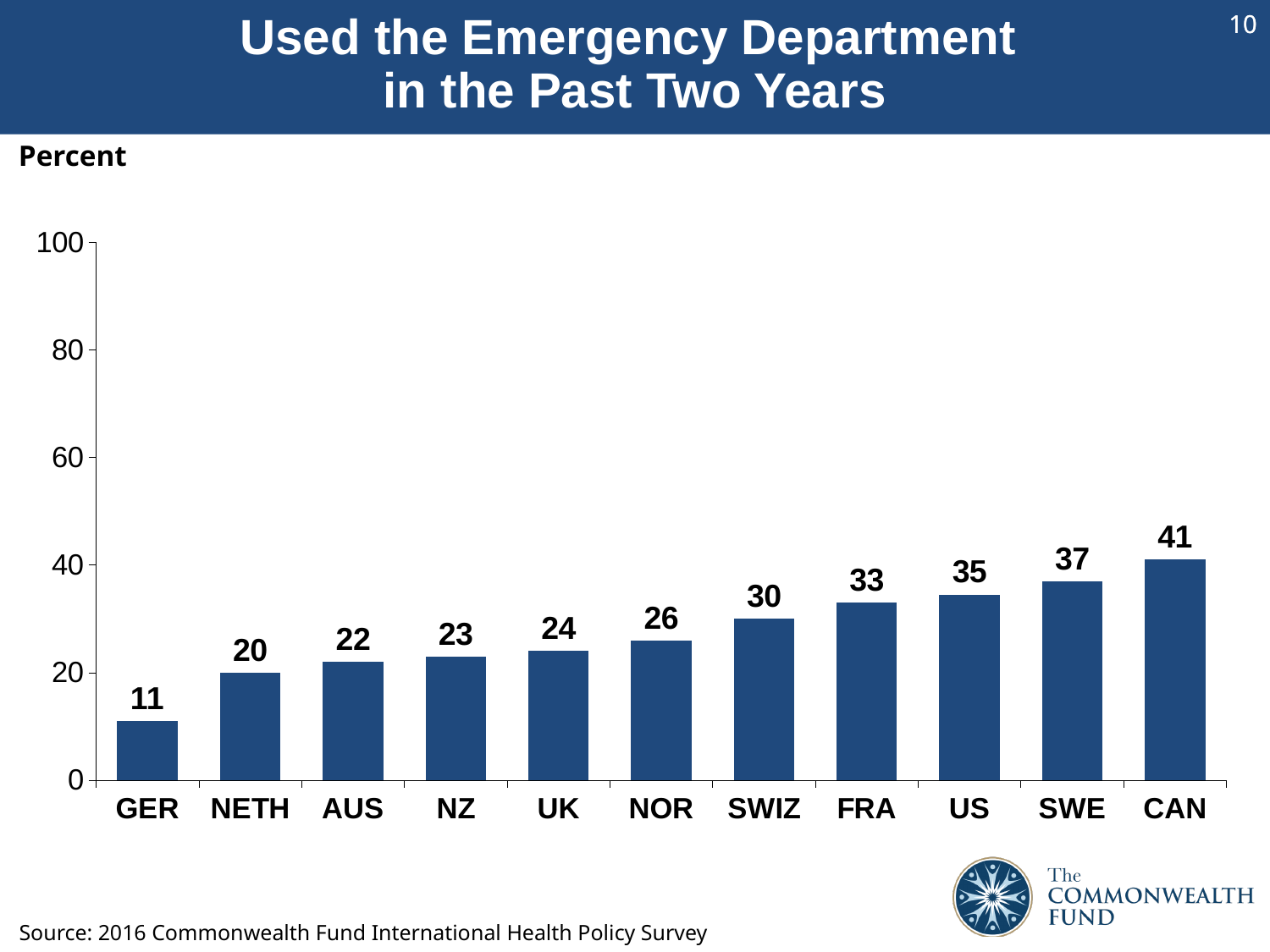
How many countries are shown on the chart? 11 Which country has the lowest value? GER What kind of chart is shown on the slide? bar chart What is the difference between the values for CAN and GER? 30 What is the difference between the values for SWE and UK? 13 Which country has the highest value? CAN Which has a larger value, FRA or NETH? FRA What is the value for NOR? 26 What is the value for GER? 11 Is the value for SWIZ greater or less than 40? less What is the value for the US? 35 Do the values rise or fall from left to right along the x axis? rise